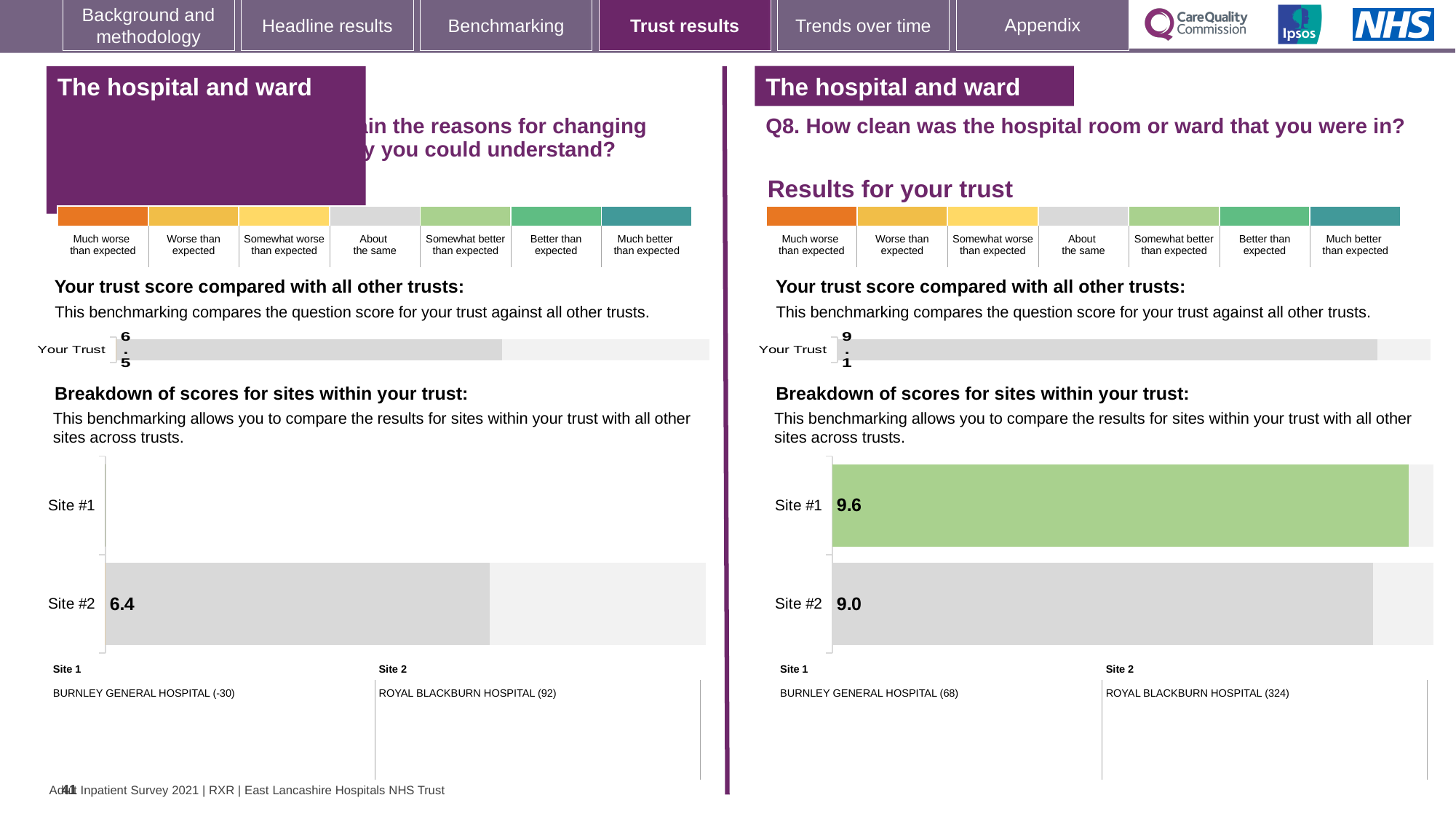
Which is larger: the Your Trust score on the left-hand chart or the Your Trust score on the right-hand Q8 chart? the right-hand Q8 chart On the left-hand chart, what is the score shown for Your Trust? 6.5 What type of chart is used for the site breakdown on the right-hand side of the slide? bar chart On the right-hand Q8 breakdown of scores for sites within your trust, what is the score for Site #1? 9.6 On the right-hand Q8 breakdown of scores for sites within your trust, what is the score for Site #2? 9.0 On the right-hand chart for Q8 (how clean was the hospital room or ward), what is the score shown for Your Trust? 9.1 How many sites are listed in the right-hand Q8 breakdown of scores chart? 2 On the right-hand Q8 site breakdown chart, which site has the higher score? Site #1 On the right-hand Q8 site breakdown chart, is the score for Site #1 or Site #2 larger? Site #1 On the right-hand Q8 site breakdown chart, what is the difference between the Site #1 and Site #2 scores? 0.6 On the left-hand breakdown of scores for sites within your trust, what is the score for Site #2? 6.4 On the right-hand Q8 site breakdown chart, what colour is the bar for Site #1? green